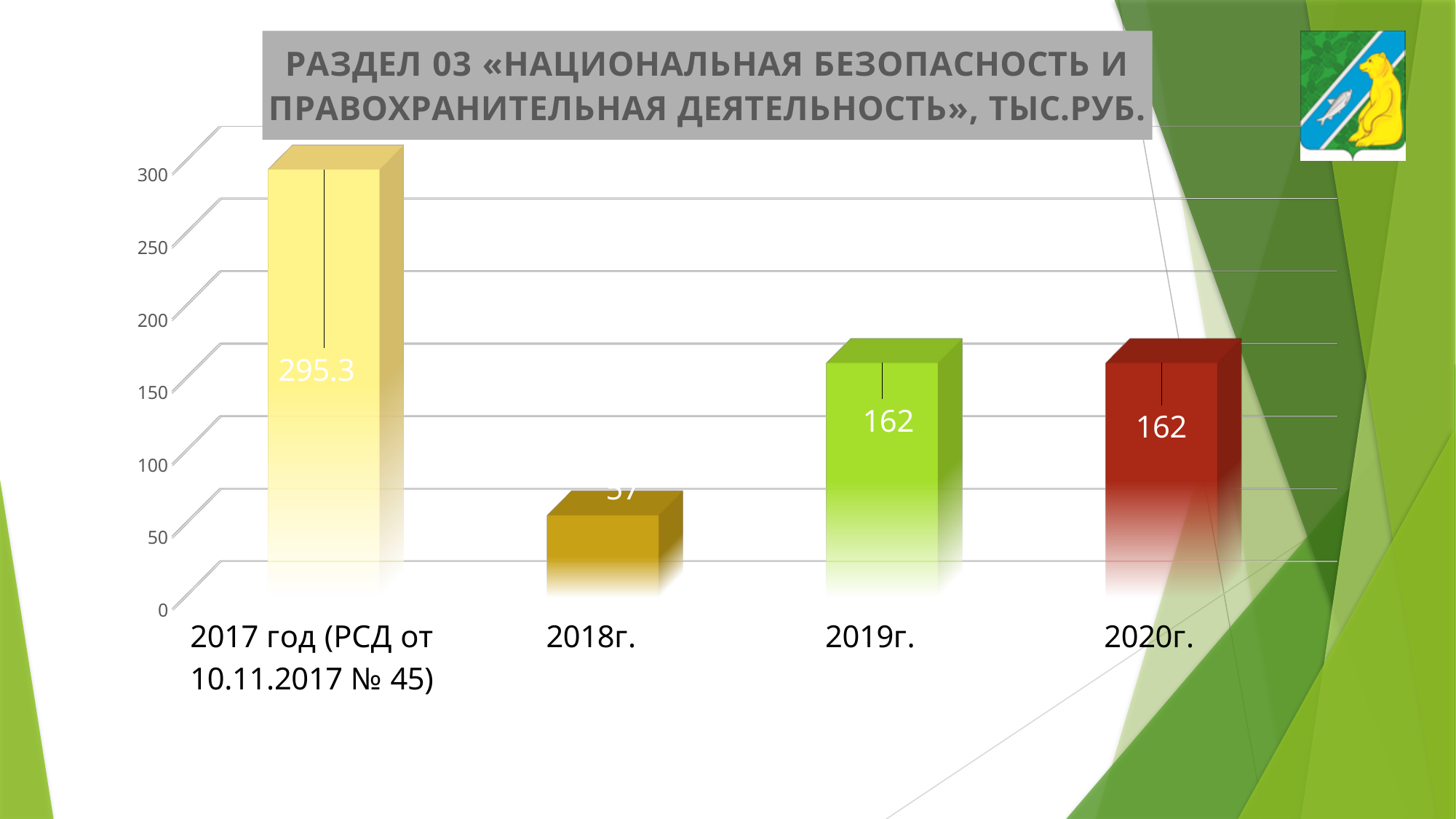
Is the value for 2019г. greater or less than 200? less Is the value for 2018г. greater or less than 100? less What is the value for 2017 год (РСД от 10.11.2017 № 45)? 295.3 What is the value for 2019г.? 162 What kind of chart is shown on the slide? bar chart Which category has the lowest value? 2018г. How many categories are shown on the x axis? 4 Which is larger, the value for 2018г. or the value for 2020г.? 2020г. What is the title of the chart? РАЗДЕЛ 03 «НАЦИОНАЛЬНАЯ БЕЗОПАСНОСТЬ И ПРАВОХРАНИТЕЛЬНАЯ ДЕЯТЕЛЬНОСТЬ», ТЫС.РУБ. What is the value for 2020г.? 162 Which category has the highest value? 2017 год (РСД от 10.11.2017 № 45) What is the difference between the values for 2017 год (РСД от 10.11.2017 № 45) and 2019г.? 133.3